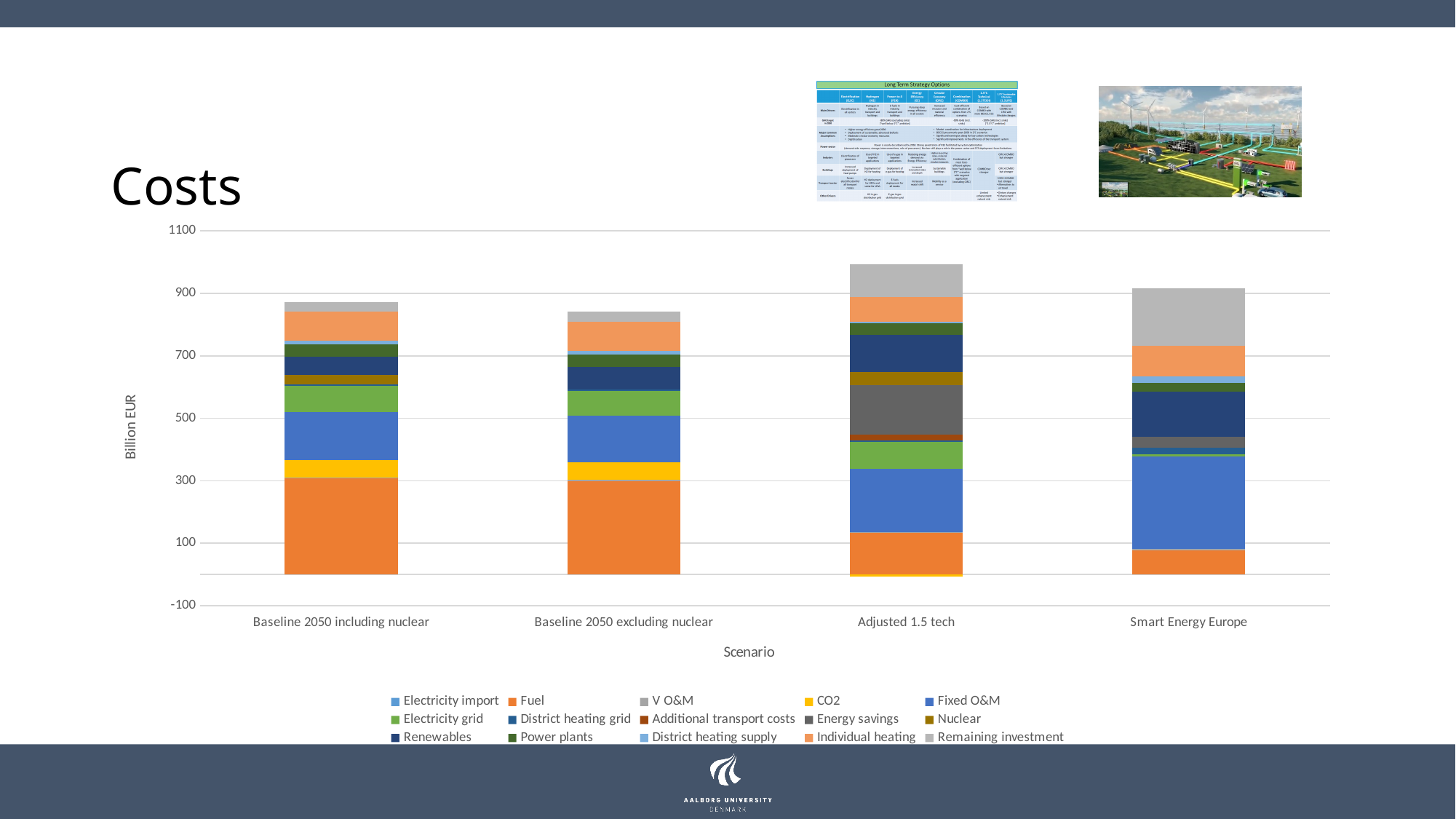
What is the label of the vertical axis of the chart? Billion EUR Which scenario has the larger Fuel segment, Baseline 2050 including nuclear or Smart Energy Europe? Baseline 2050 including nuclear Is the total stacked value for Baseline 2050 excluding nuclear greater or less than 900? less Is the total stacked value for Adjusted 1.5 tech greater or less than 900? greater Is the Fuel value for Smart Energy Europe greater or less than 100? less What is the label of the horizontal axis of the chart? Scenario What kind of chart is shown on the slide? Stacked bar chart How many scenarios are shown on the x axis of the chart? 4 Which scenario has the tallest stacked bar in the chart? Adjusted 1.5 tech How many series does the chart legend list? 15